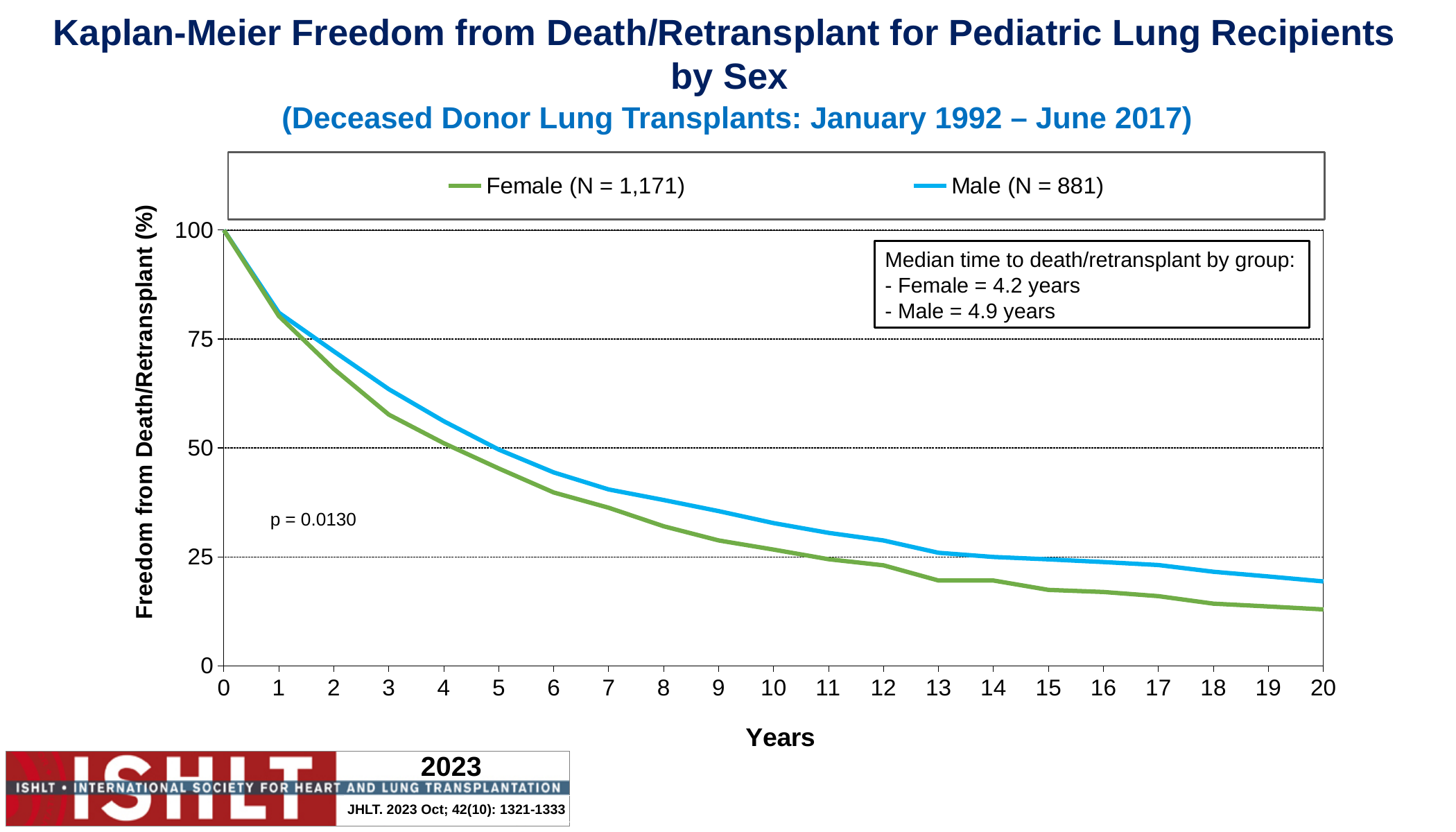
At 10 years, which curve is higher, Female or Male? Male What is the difference between the Male and Female median times to death/retransplant? 0.7 years Do the freedom from death/retransplant values rise or fall as years increase? Fall Which group has the longer median time to death/retransplant, Female or Male? Male Is the Male freedom from death/retransplant at 1 year greater or less than 75? greater How many series does the legend list? 2 Is the Female freedom from death/retransplant at 20 years greater or less than 25? less What is the p-value shown on the chart? p = 0.0130 What kind of chart is shown on the slide? Line chart What is the median time to death/retransplant for the Male group? 4.9 years What is the N for the Female group shown in the legend? 1,171 What is the median time to death/retransplant for the Female group? 4.2 years